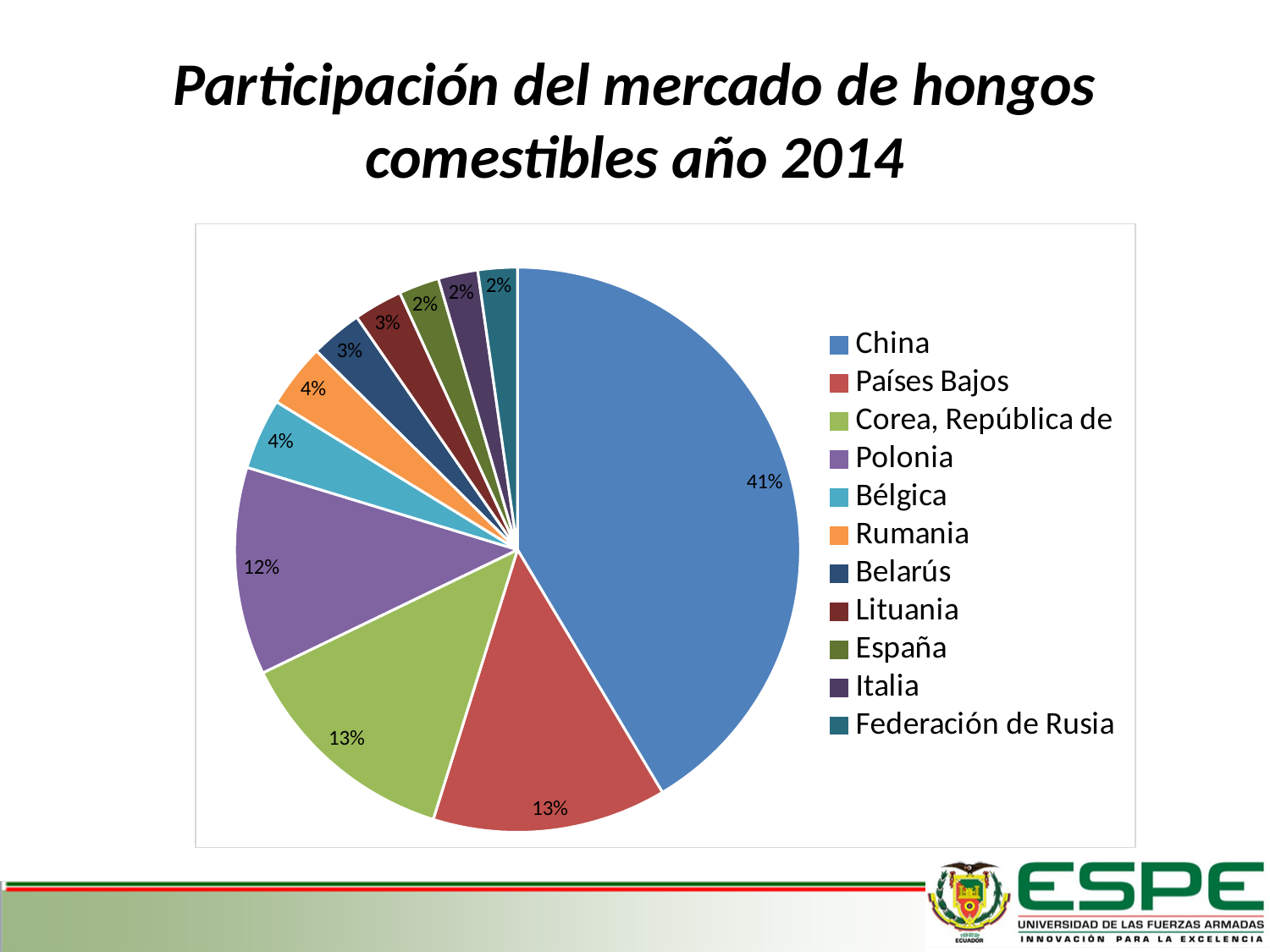
Which has a larger share, Países Bajos or Rumania? Países Bajos What share of the market does Polonia hold? 12% What is the title of the slide? Participación del mercado de hongos comestibles año 2014 What kind of chart is shown on the slide? pie chart Which country has the largest share of the market? China What share of the market does Belarús hold? 3% What is the combined share of Países Bajos and Corea, República de? 26% How many countries are shown in the pie chart? 11 What is the difference between China's share and Polonia's share? 29% What share of the market does Federación de Rusia hold? 2% What share of the market does Bélgica hold? 4% What share of the market does China hold? 41%